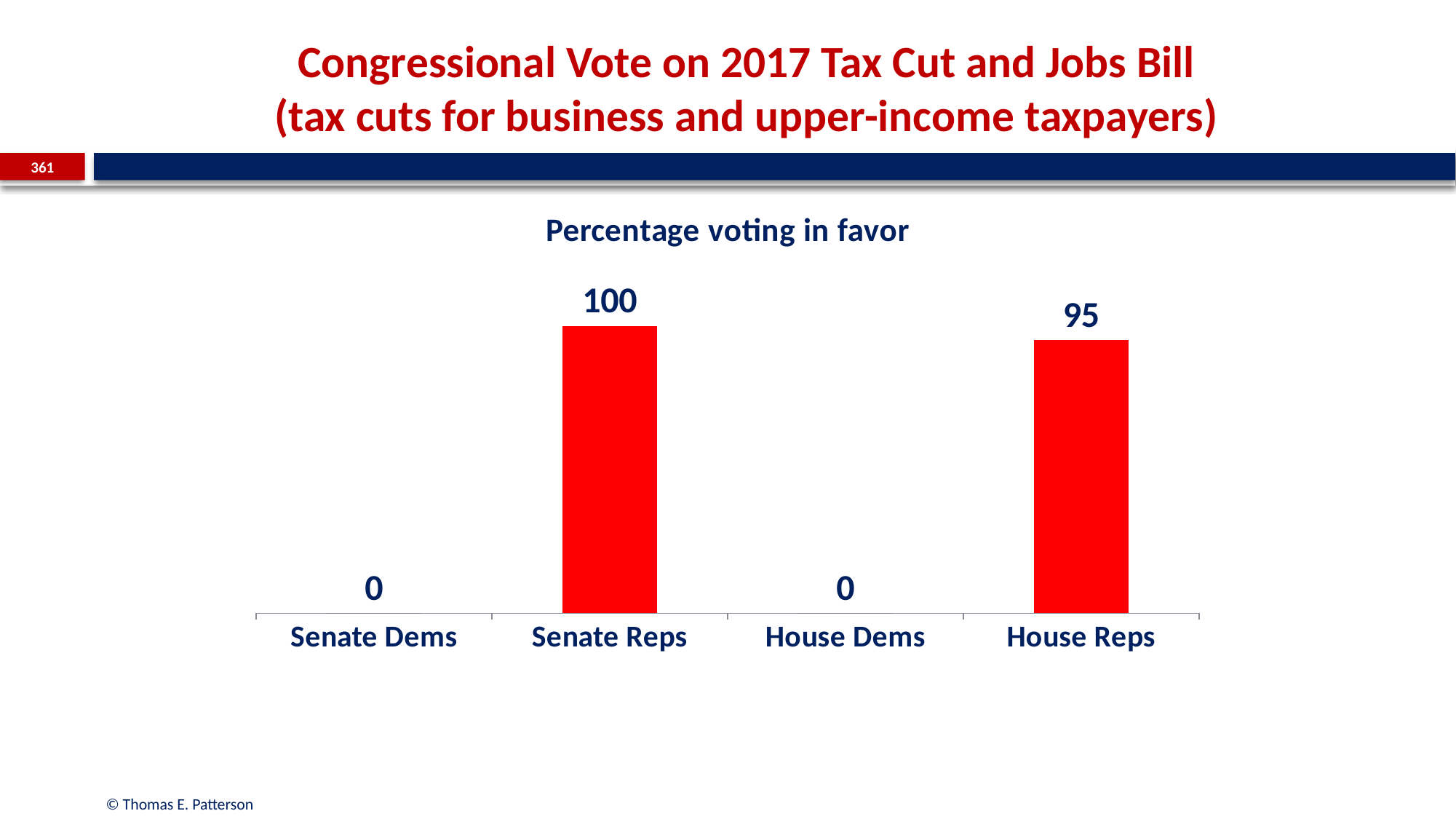
What is the value for House Dems? 0 Which is larger, the value for House Reps or the value for House Dems? House Reps What colour are the bars in the chart? red What is the value for House Reps? 95 Which is larger, the value for Senate Reps or the value for House Reps? Senate Reps What is the value for Senate Reps? 100 What is the title of the chart? Percentage voting in favor What is the value for Senate Dems? 0 What kind of chart is shown on the slide? bar chart What is the difference between the values for Senate Reps and House Reps? 5 Which category has the highest value? Senate Reps How many categories are shown on the x axis? 4